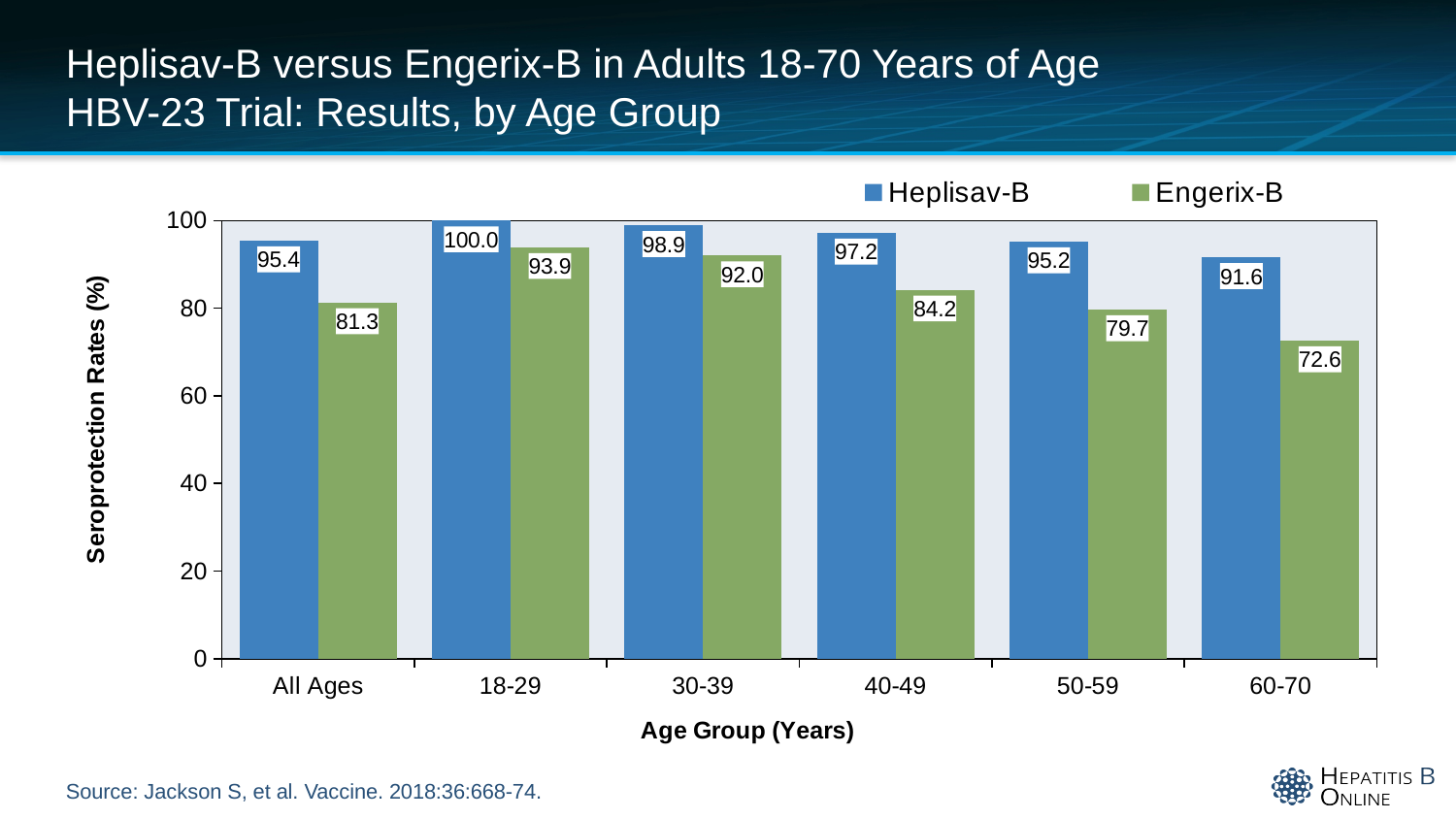
Which age group has the lowest Engerix-B seroprotection rate? 60-70 How many age group categories are shown on the x axis? 6 What kind of chart is shown on the slide? Bar chart Which is larger for the 50-59 age group, the Heplisav-B rate or the Engerix-B rate? Heplisav-B Do the Engerix-B seroprotection rates rise or fall from the 18-29 age group to the 60-70 age group? fall What is the Engerix-B seroprotection rate for the 60-70 age group? 72.6 What is the difference between the Heplisav-B and Engerix-B seroprotection rates for the 40-49 age group? 13.0 How many series does the legend list? 2 Which age group has the highest Heplisav-B seroprotection rate? 18-29 What is the Engerix-B seroprotection rate for All Ages? 81.3 What is the Heplisav-B seroprotection rate for the 18-29 age group? 100.0 Is the Engerix-B seroprotection rate for the 50-59 age group greater or less than 80? less